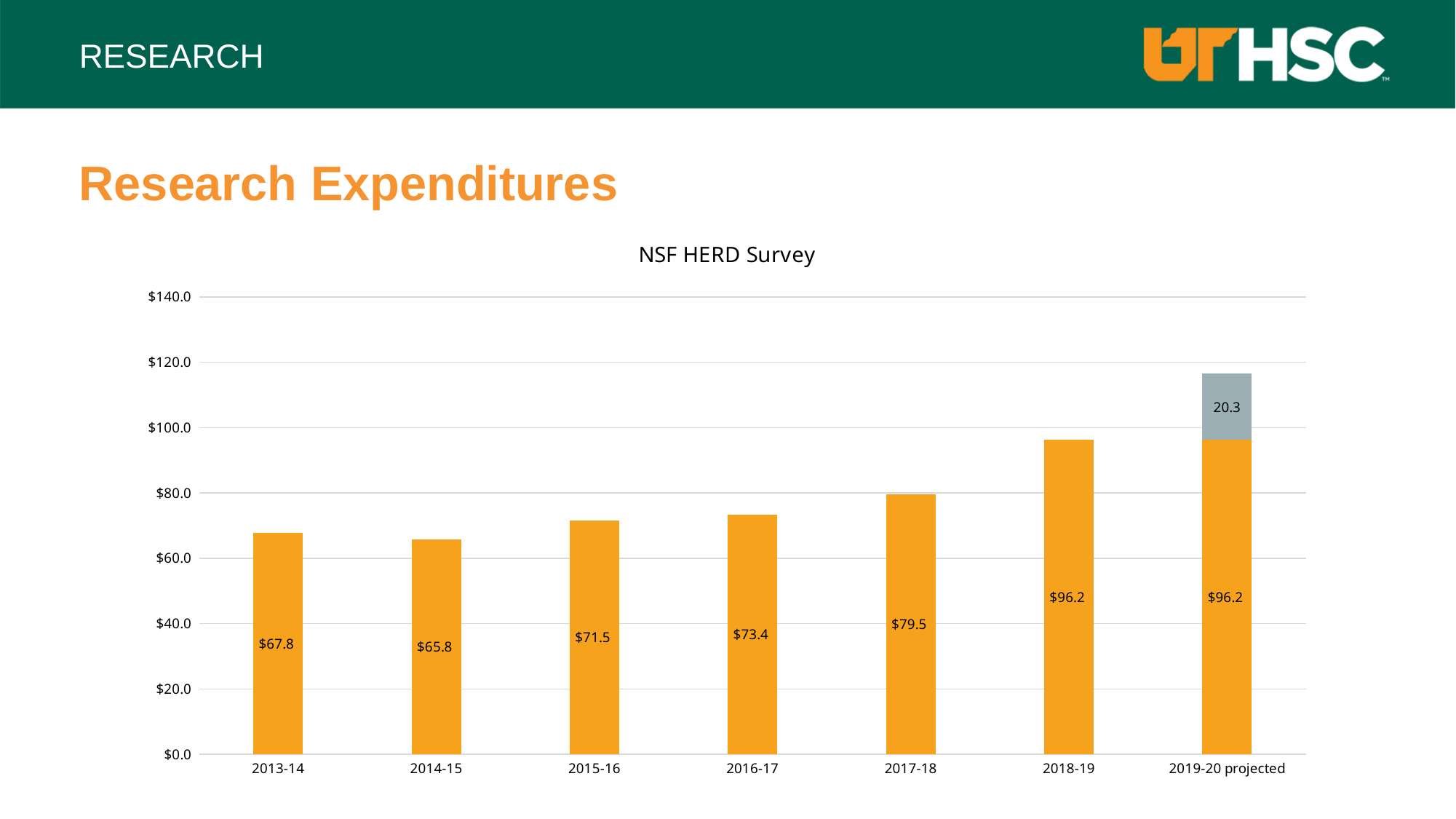
Which bar is the tallest in the NSF HERD Survey chart? 2019-20 projected What is the value for 2013-14 in the NSF HERD Survey chart? $67.8 What is the value of the gray projected segment on the 2019-20 projected bar? 20.3 Is the value for 2018-19 greater or less than $80.0? greater How many years are shown on the x axis of the NSF HERD Survey chart? 7 Which year has the lowest value in the NSF HERD Survey chart? 2014-15 What is the value for 2017-18 in the NSF HERD Survey chart? $79.5 What is the difference between the values for 2018-19 and 2017-18? $16.7 What kind of chart is the NSF HERD Survey chart? bar chart Do the values generally rise or fall from 2014-15 to 2018-19? rise Which is larger, the value for 2015-16 or the value for 2016-17? 2016-17 What is the total of the stacked 2019-20 projected bar? $116.5